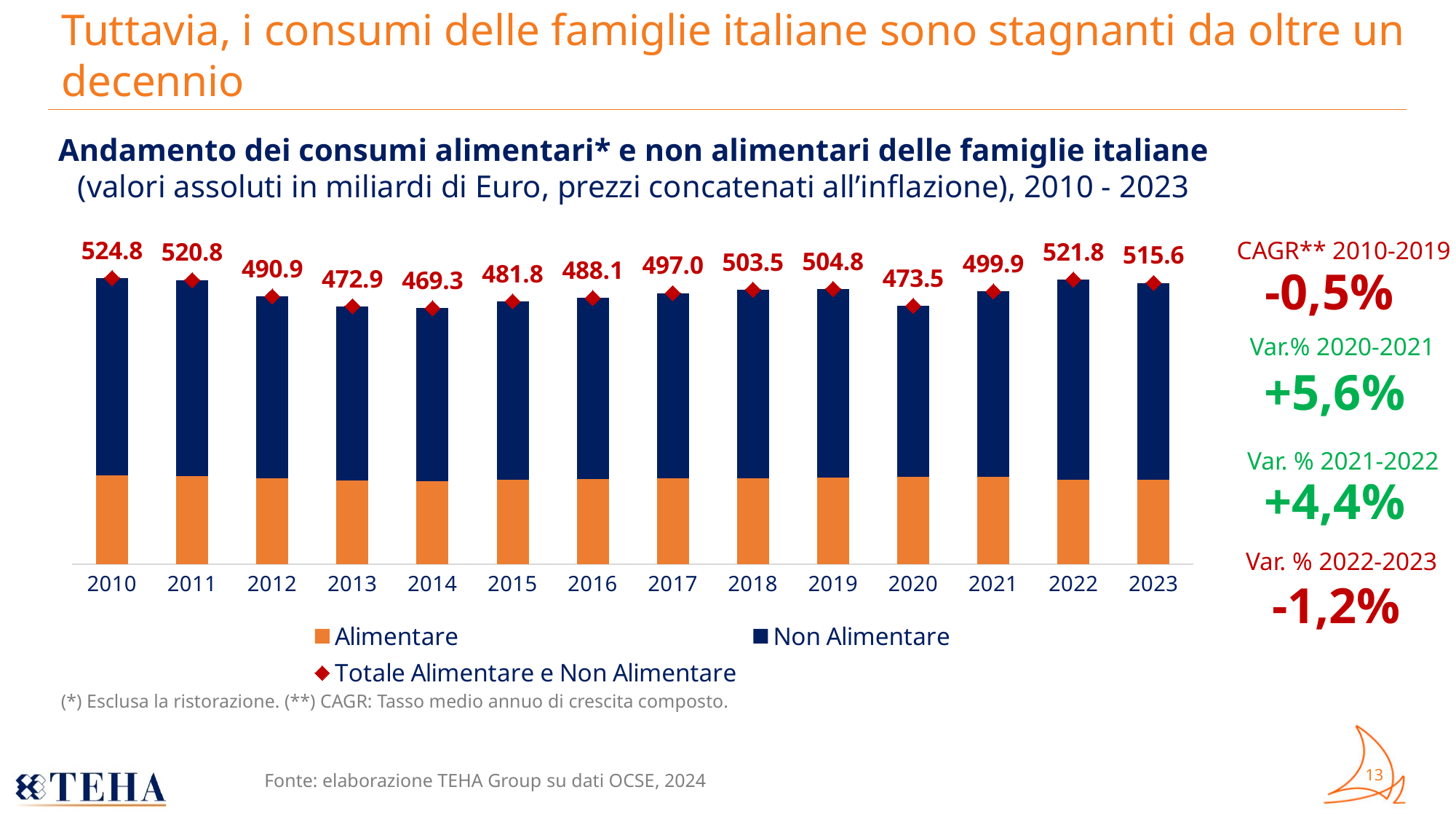
Which year has a larger total value, 2019 or 2020? 2019 What is the difference between the total value for 2022 and the total value for 2023? 6.2 Do the total values rise or fall from 2010 to 2014? Fall How many years are shown on the x axis of the chart? 14 What is the total value (Totale Alimentare e Non Alimentare) for 2010? 524.8 What is the total value shown for 2023? 515.6 What is the total value shown for 2020? 473.5 Which year has the lowest total value? 2014 How many series does the legend list? 3 What is the difference between the total value for 2010 and the total value for 2023? 9.2 What kind of chart is shown on the slide? Stacked bar chart Which year has the highest total value? 2010